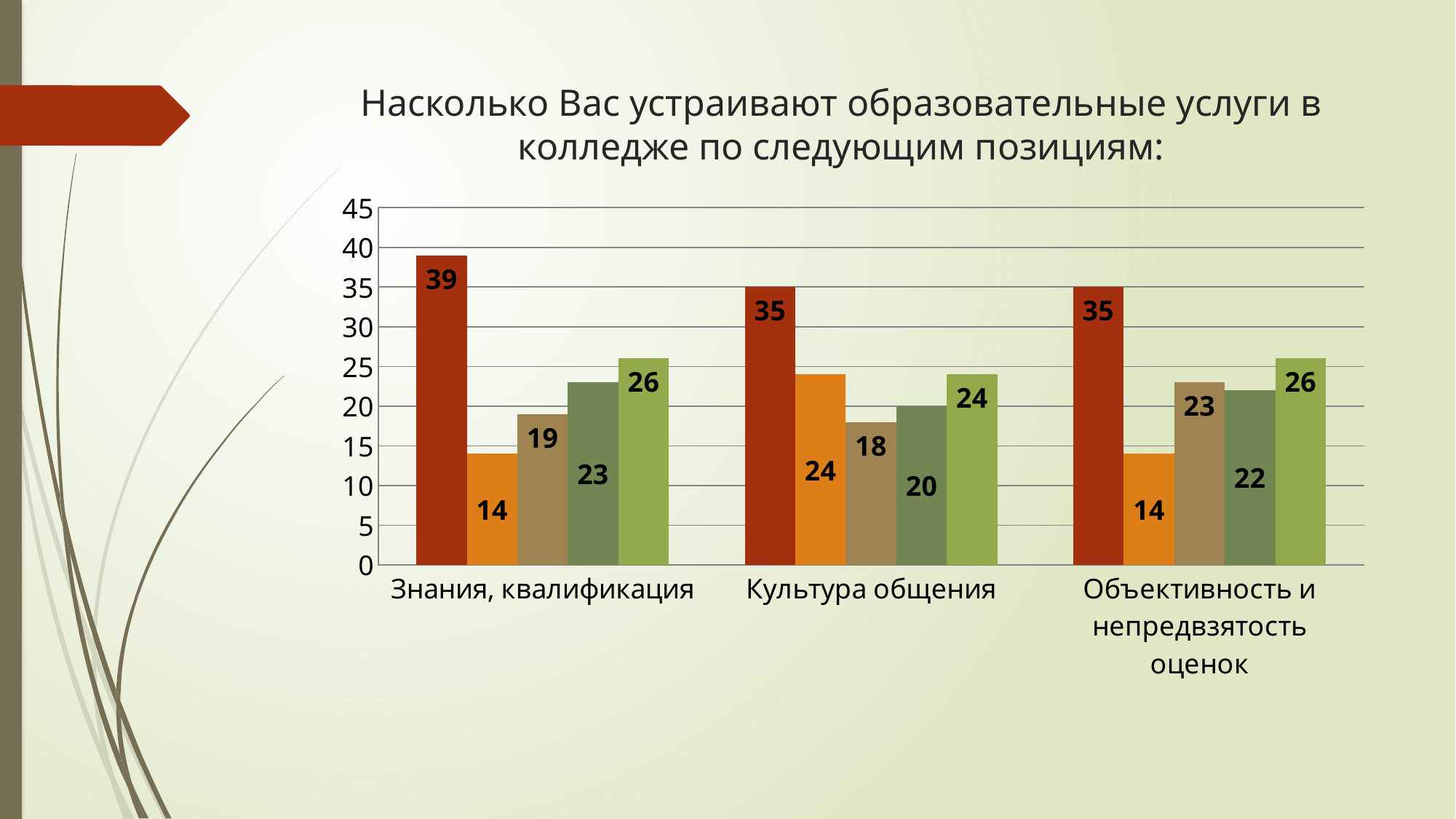
What type of chart is shown on the slide? bar chart What is the difference between the dark red bar and the orange bar for "Знания, квалификация"? 25 Which is larger for "Культура общения": the light green bar or the tan (brown) bar? the light green bar What is the value of the dark red bar for "Знания, квалификация"? 39 What is the value of the dark green bar for "Культура общения"? 20 How many categories are shown on the x axis? 3 How many bars are plotted for each category? 5 Which bar is the lowest in the "Знания, квалификация" group? the orange bar (14) What is the value of the orange bar for "Культура общения"? 24 Which category has the highest dark red bar? Знания, квалификация What is the title of the chart? Насколько Вас устраивают образовательные услуги в колледже по следующим позициям: What is the value of the tan (brown) bar for "Объективность и непредвзятость оценок"? 23